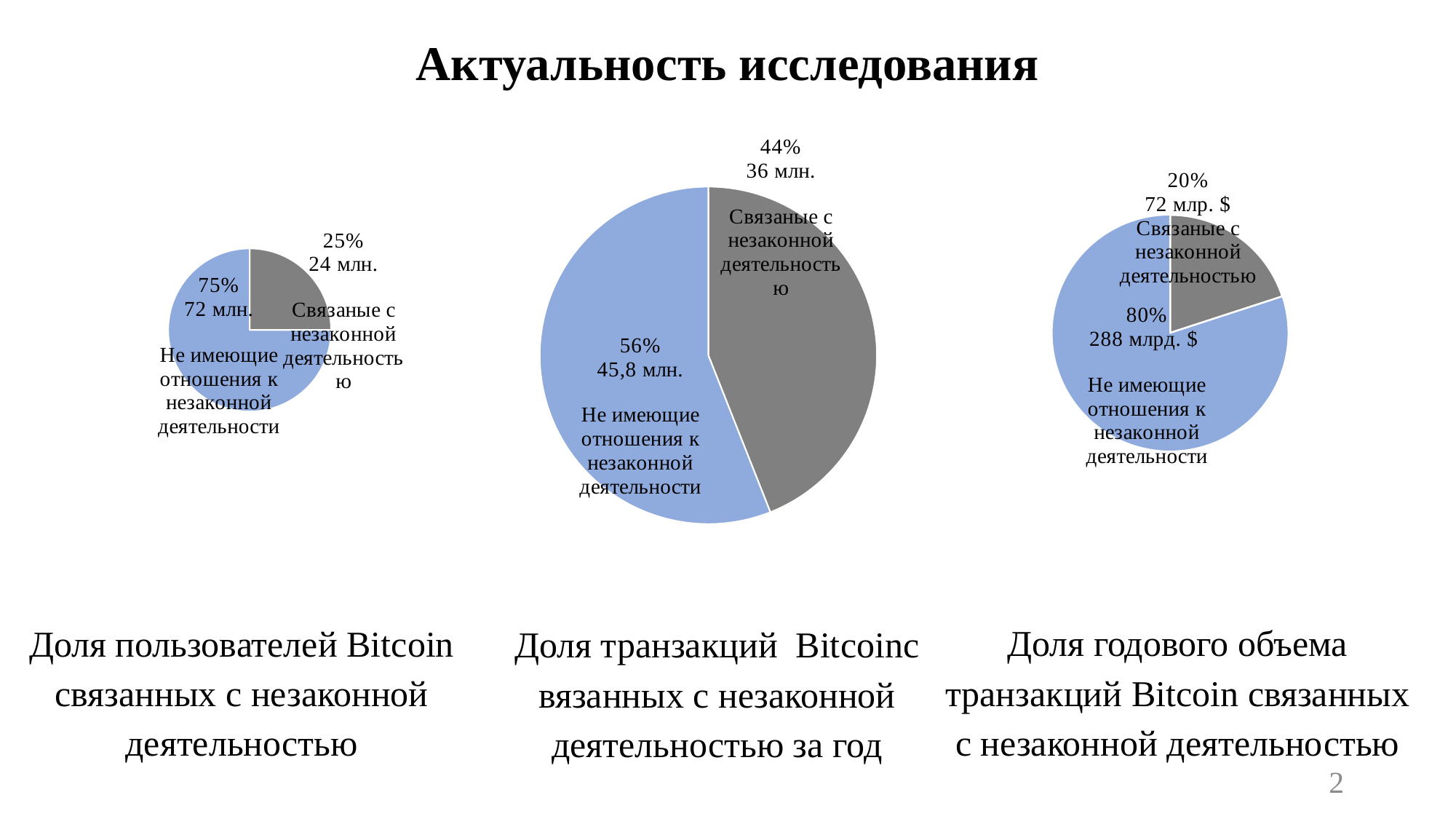
In the right chart (Доля годового объема транзакций Bitcoin), what is the difference in percentage points between the two slices? 60 How many pie charts are shown on the slide? 3 In the middle chart (Доля транзакций Bitcoin за год), what share of transactions is 'Связаные с незаконной деятельностью'? 44% What type of chart is used for 'Доля пользователей Bitcoin связанных с незаконной деятельностью' (left chart)? Pie chart In the middle chart (Доля транзакций Bitcoin за год), what value is printed for 'Не имеющие отношения к незаконной деятельности'? 45,8 млн. In the left chart (Доля пользователей Bitcoin), what share of users is 'Связаные с незаконной деятельностью'? 25% In the left chart (Доля пользователей Bitcoin), what value is printed for 'Не имеющие отношения к незаконной деятельности'? 72 млн. In the right chart (Доля годового объема транзакций Bitcoin), what share is 'Не имеющие отношения к незаконной деятельности'? 80% How many slices does each pie chart on the slide have? 2 In the left chart (Доля пользователей Bitcoin), how many million users are 'Связаные с незаконной деятельностью'? 24 млн. In the right chart (Доля годового объема транзакций Bitcoin), what value is printed for 'Связаные с незаконной деятельностью'? 72 млр. $ In the middle chart (Доля транзакций Bitcoin за год), which slice is larger: 'Связаные с незаконной деятельностью' or 'Не имеющие отношения к незаконной деятельности'? Не имеющие отношения к незаконной деятельности